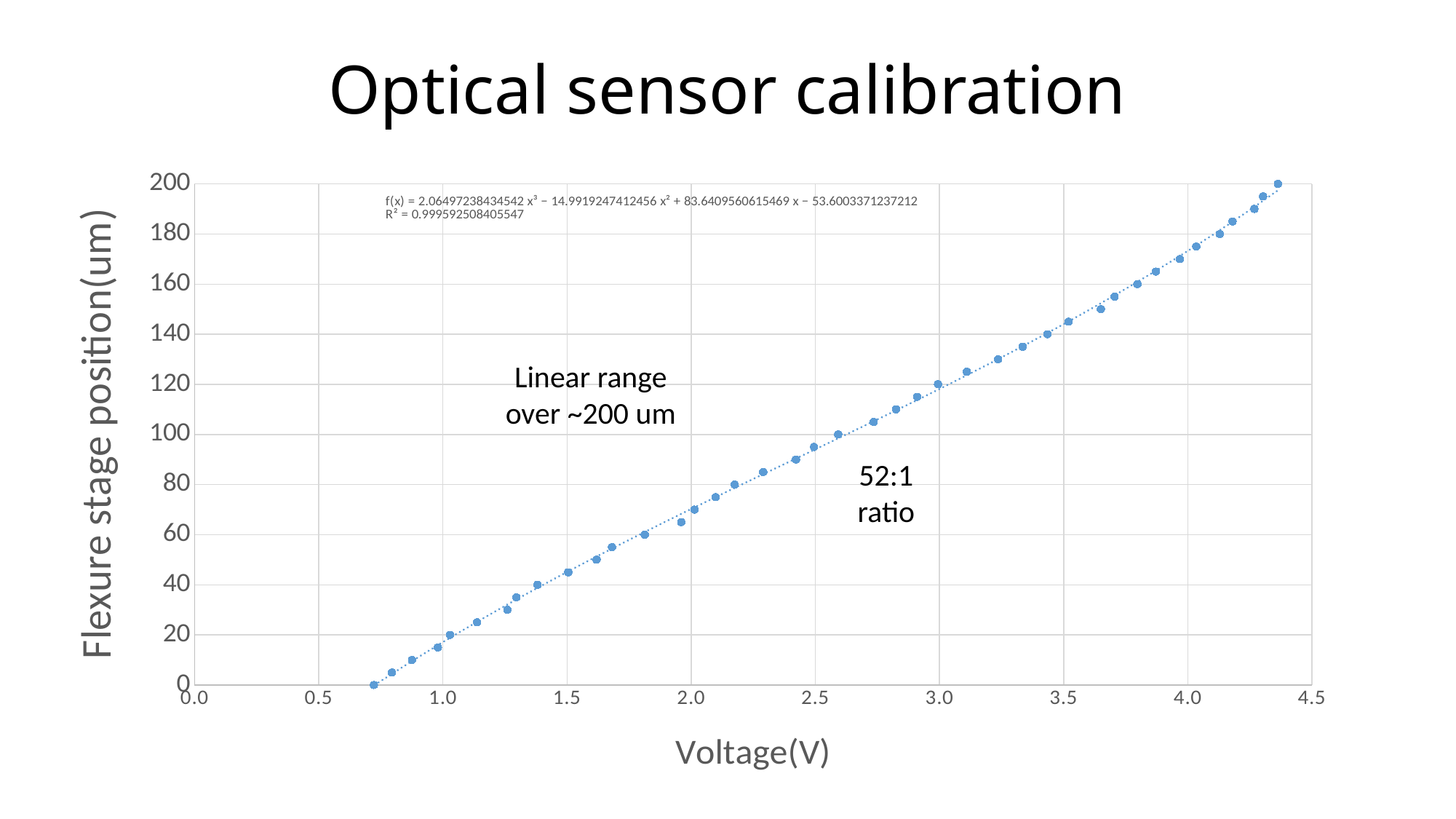
What is the flexure stage position at a voltage of 3.0 V? 120 Is the flexure stage position at 1.5 V greater or less than 40? greater Is the flexure stage position at 4.0 V greater or less than 160? greater Is the flexure stage position at 2.5 V greater or less than 100? less Do the flexure stage position values rise or fall as voltage increases? Rise What is the title of the chart? Optical sensor calibration What is the highest flexure stage position plotted? 200 What is the lowest flexure stage position plotted? 0 Is the flexure stage position at 3.5 V larger than the position at 2.0 V? Yes What kind of chart is shown on the slide? Scatter chart What is the label of the y axis? Flexure stage position(um)